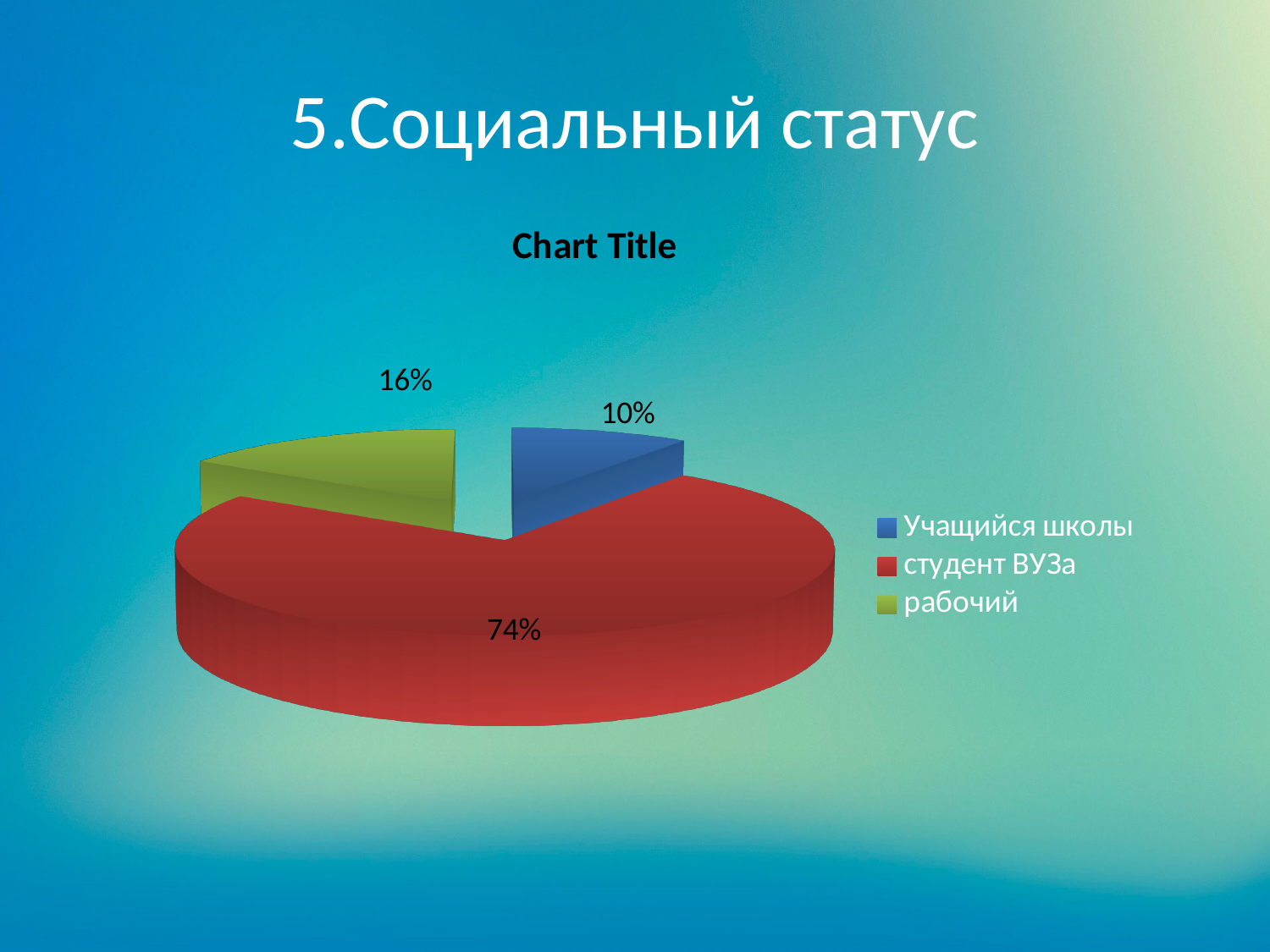
What is the difference in percentage points between студент ВУЗа and рабочий? 58 What share of the pie does Учащийся школы have? 10% Which category has the smallest slice of the pie? Учащийся школы What is the title of the chart? Chart Title What share of the pie does рабочий have? 16% How many slices does the pie chart have? 3 What share of the pie does студент ВУЗа have? 74% What is the difference in percentage points between рабочий and Учащийся школы? 6 What colour is the slice for студент ВУЗа? red Which category has the largest slice of the pie? студент ВУЗа Which is larger, the slice for рабочий or the slice for Учащийся школы? рабочий What type of chart is shown on the slide? pie chart